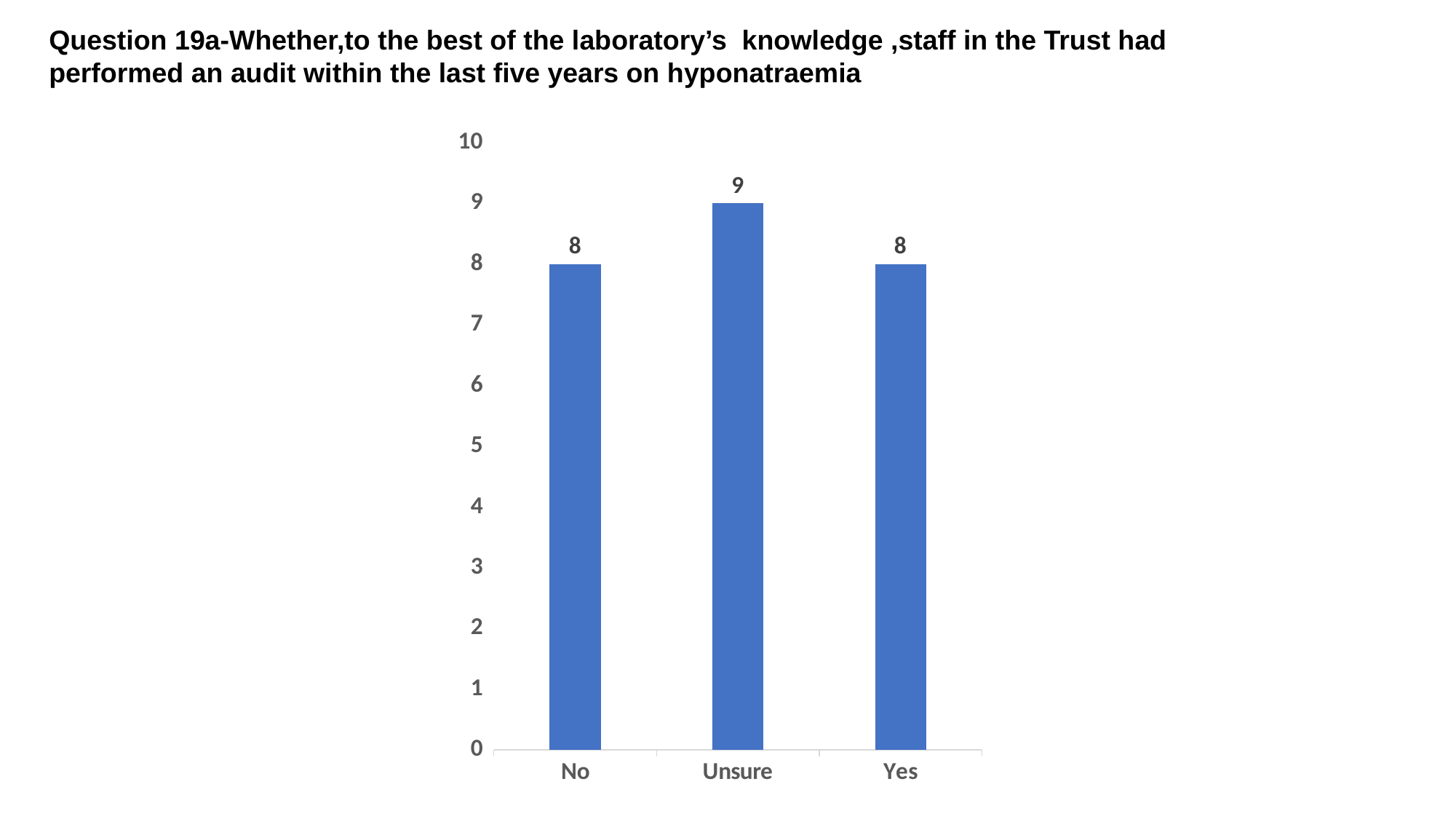
What is the value for the "Yes" category? 8 How many categories are shown on the x axis? 3 What colour are the bars in the chart? blue Is the value for "Unsure" greater or less than 5? greater What kind of chart is shown on the slide? bar chart Which is larger, the value for "Unsure" or the value for "No"? Unsure Which category has the highest value? Unsure What is the value for the "Unsure" category? 9 What is the value for the "No" category? 8 What is the difference between the values for "Unsure" and "Yes"? 1 What is the maximum value shown on the y axis? 10 What is the total of the values for "No", "Unsure" and "Yes"? 25